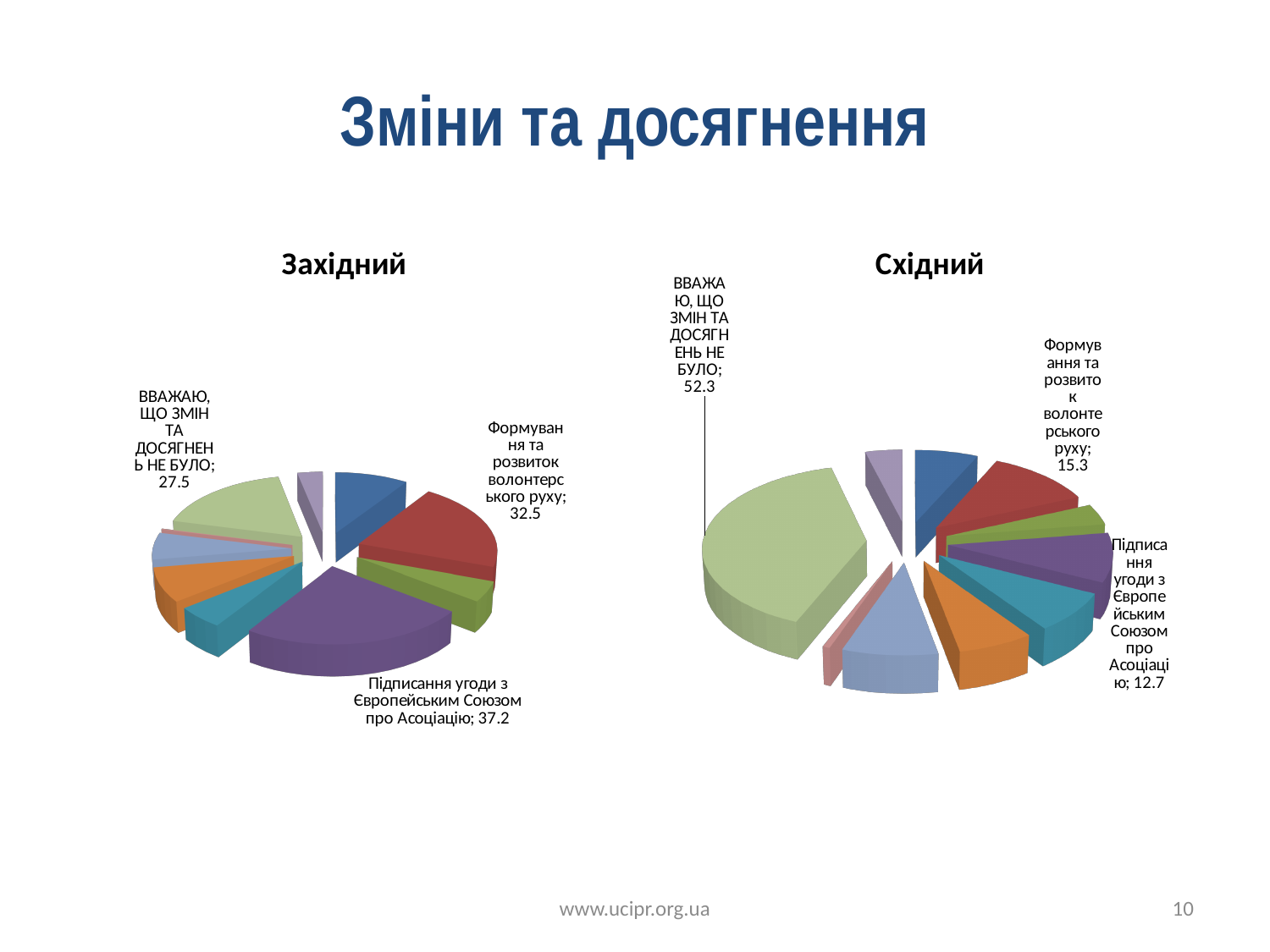
What is the title of the slide? Зміни та досягнення In the Західний chart, what is the value for 'ВВАЖАЮ, ЩО ЗМІН ТА ДОСЯГНЕНЬ НЕ БУЛО'? 27.5 Which chart shows a larger value for 'Формування та розвиток волонтерського руху', Західний or Східний? Західний In the Східний chart, what is the difference between the values for 'Формування та розвиток волонтерського руху' and 'Підписання угоди з Європейським Союзом про Асоціацію'? 2.6 What kind of chart is the Східний chart? Pie chart In the Західний chart, what is the value for 'Формування та розвиток волонтерського руху'? 32.5 In the Східний chart, which category has the largest slice? ВВАЖАЮ, ЩО ЗМІН ТА ДОСЯГНЕНЬ НЕ БУЛО In the Східний chart, what is the value for 'ВВАЖАЮ, ЩО ЗМІН ТА ДОСЯГНЕНЬ НЕ БУЛО'? 52.3 In the Західний chart, what is the difference between the values for 'Підписання угоди з Європейським Союзом про Асоціацію' and 'Формування та розвиток волонтерського руху'? 4.7 In the Західний chart, what is the value for 'Підписання угоди з Європейським Союзом про Асоціацію'? 37.2 In the Східний chart, what is the value for 'Формування та розвиток волонтерського руху'? 15.3 In the Східний chart, what is the value for 'Підписання угоди з Європейським Союзом про Асоціацію'? 12.7